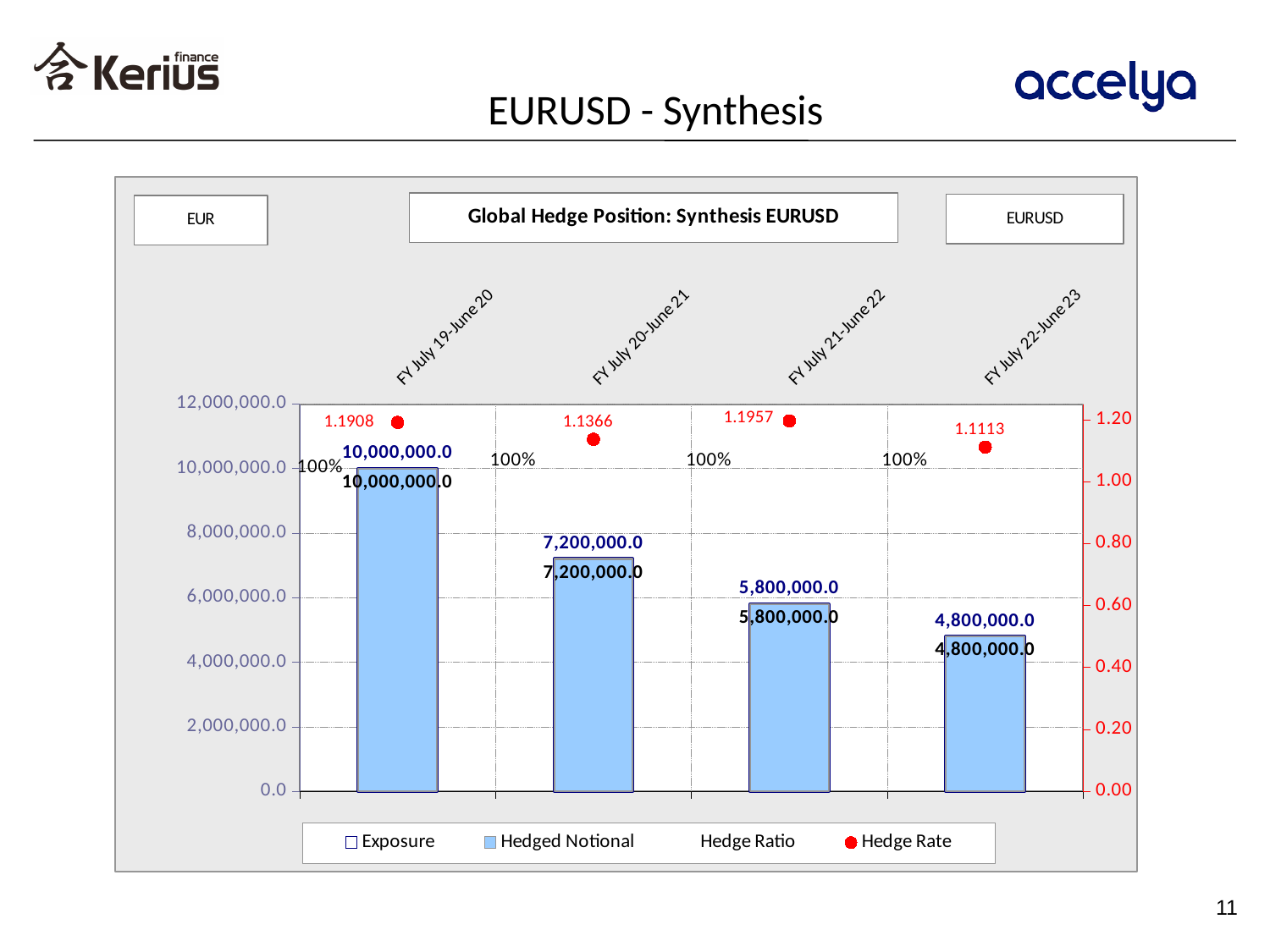
Which fiscal year has the highest Hedge Rate? FY July 21-June 22 What is the difference in Hedged Notional between FY July 19-June 20 and FY July 21-June 22? 4,200,000.0 What is the Exposure for FY July 22-June 23? 4,800,000.0 Which is larger, the Hedge Rate for FY July 20-June 21 or for FY July 22-June 23? FY July 20-June 21 What is the Hedged Notional for FY July 20-June 21? 7,200,000.0 What is the title of the chart? Global Hedge Position: Synthesis EURUSD Does the Hedged Notional rise or fall across the fiscal years from left to right? fall How many series does the legend list? 4 How many fiscal year categories are shown on the x axis? 4 What is the Hedge Rate for FY July 19-June 20? 1.1908 Which fiscal year has the lowest Hedged Notional? FY July 22-June 23 What is the Hedge Ratio for FY July 21-June 22? 100%